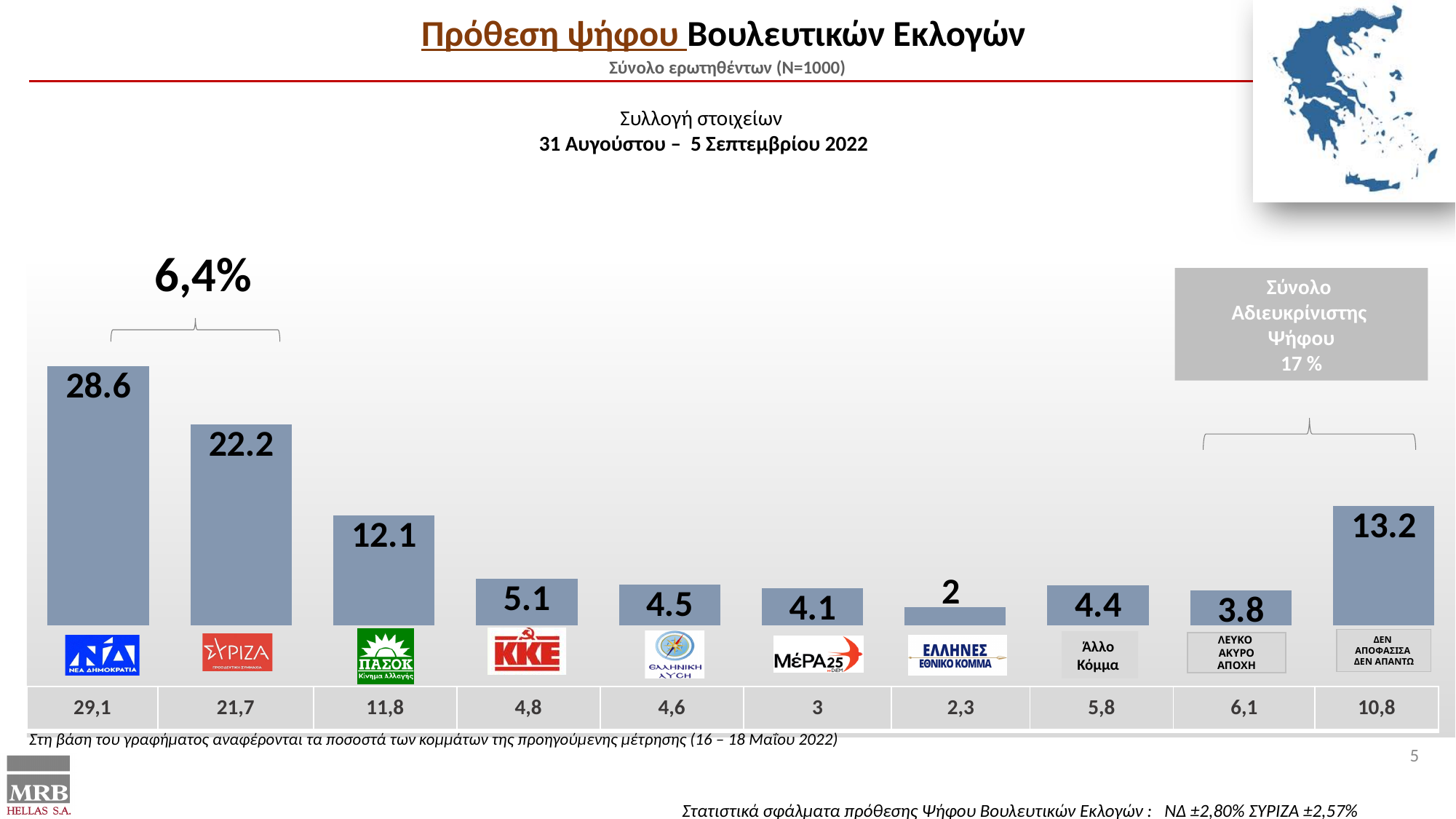
Which has a larger value, ΚΚΕ or ΜέΡΑ25? ΚΚΕ What kind of chart is shown on the slide? bar chart How many bars are plotted in the chart? 10 What is the difference between the values for ΝΕΑ ΔΗΜΟΚΡΑΤΙΑ and ΣΥΡΙΖΑ? 6.4 What is the value shown for ΣΥΡΙΖΑ in the chart? 22.2 Which category has the highest bar in the chart? ΝΕΑ ΔΗΜΟΚΡΑΤΙΑ Which category has the lowest bar in the chart? ΕΛΛΗΝΕΣ ΕΘΝΙΚΟ ΚΟΜΜΑ What is the value shown for ΚΚΕ in the chart? 5.1 What is the value shown for ΠΑΣΟΚ in the chart? 12.1 What is the value shown for ΝΕΑ ΔΗΜΟΚΡΑΤΙΑ in the chart? 28.6 What percentage is given in the grey box for Σύνολο Αδιευκρίνιστης Ψήφου? 17 % What is the value shown for the ΔΕΝ ΑΠΟΦΑΣΙΣΑ / ΔΕΝ ΑΠΑΝΤΩ bar? 13.2